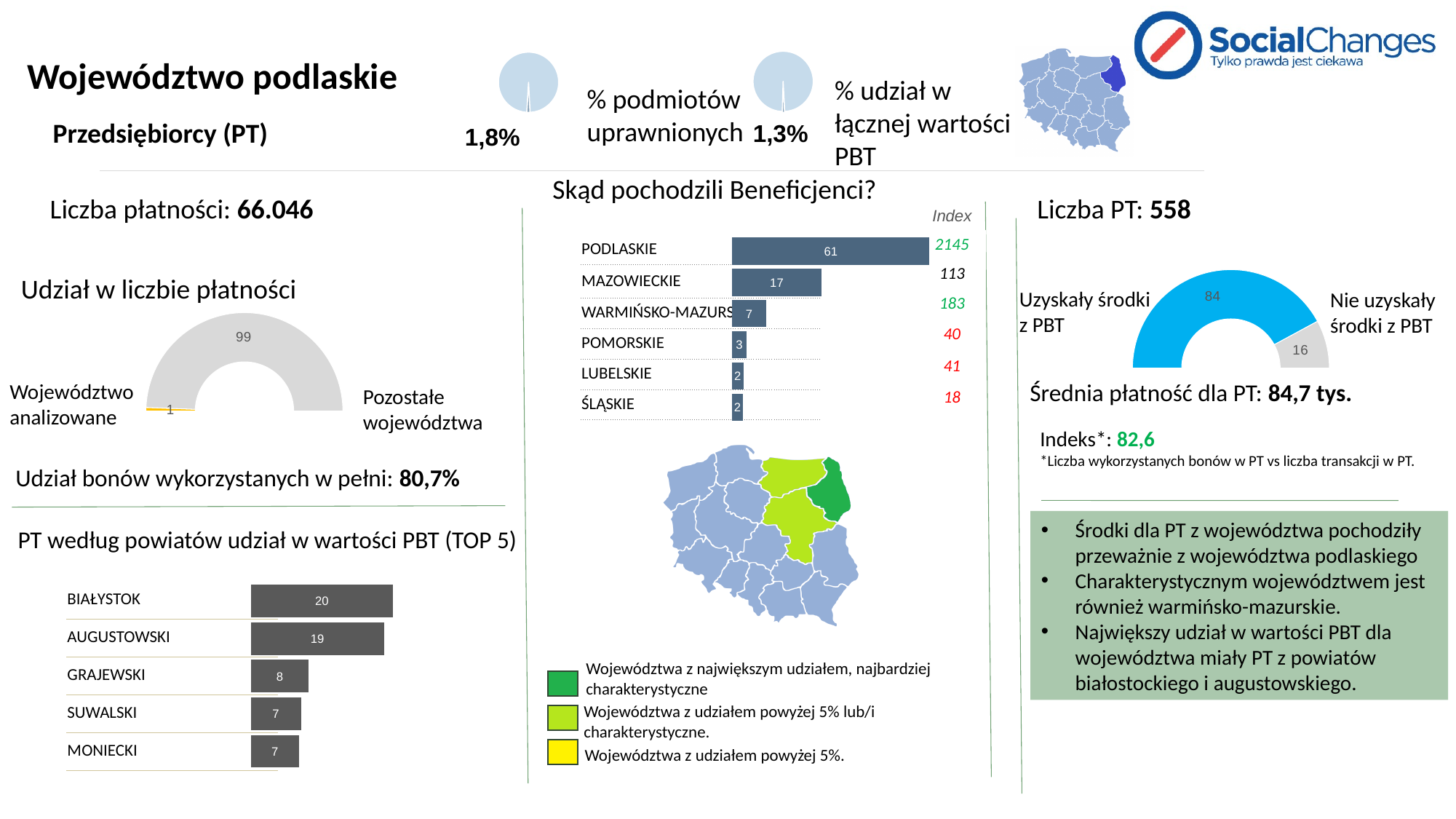
How many voivodeships are listed in the 'Skąd pochodzili Beneficjenci?' chart? 6 In the 'PT według powiatów udział w wartości PBT (TOP 5)' chart, what is the value for GRAJEWSKI? 8 In the 'Liczba PT' gauge chart, what is the value for 'Uzyskały środki z PBT'? 84 In the 'PT według powiatów udział w wartości PBT (TOP 5)' chart, which is larger: AUGUSTOWSKI or GRAJEWSKI? AUGUSTOWSKI In the 'Skąd pochodzili Beneficjenci?' chart, what is the value for MAZOWIECKIE? 17 In the 'Udział w liczbie płatności' gauge chart, what is the value for 'Pozostałe województwa'? 99 In the 'Skąd pochodzili Beneficjenci?' chart, what is the value for PODLASKIE? 61 In the 'Skąd pochodzili Beneficjenci?' chart, what is the difference between PODLASKIE and MAZOWIECKIE? 44 What kind of chart is 'PT według powiatów udział w wartości PBT (TOP 5)'? Bar chart In the 'Skąd pochodzili Beneficjenci?' chart, which voivodeship has the highest value? PODLASKIE In the 'PT według powiatów udział w wartości PBT (TOP 5)' chart, which powiat has the highest value? BIAŁYSTOK In the 'PT według powiatów udział w wartości PBT (TOP 5)' chart, what is the value for BIAŁYSTOK? 20